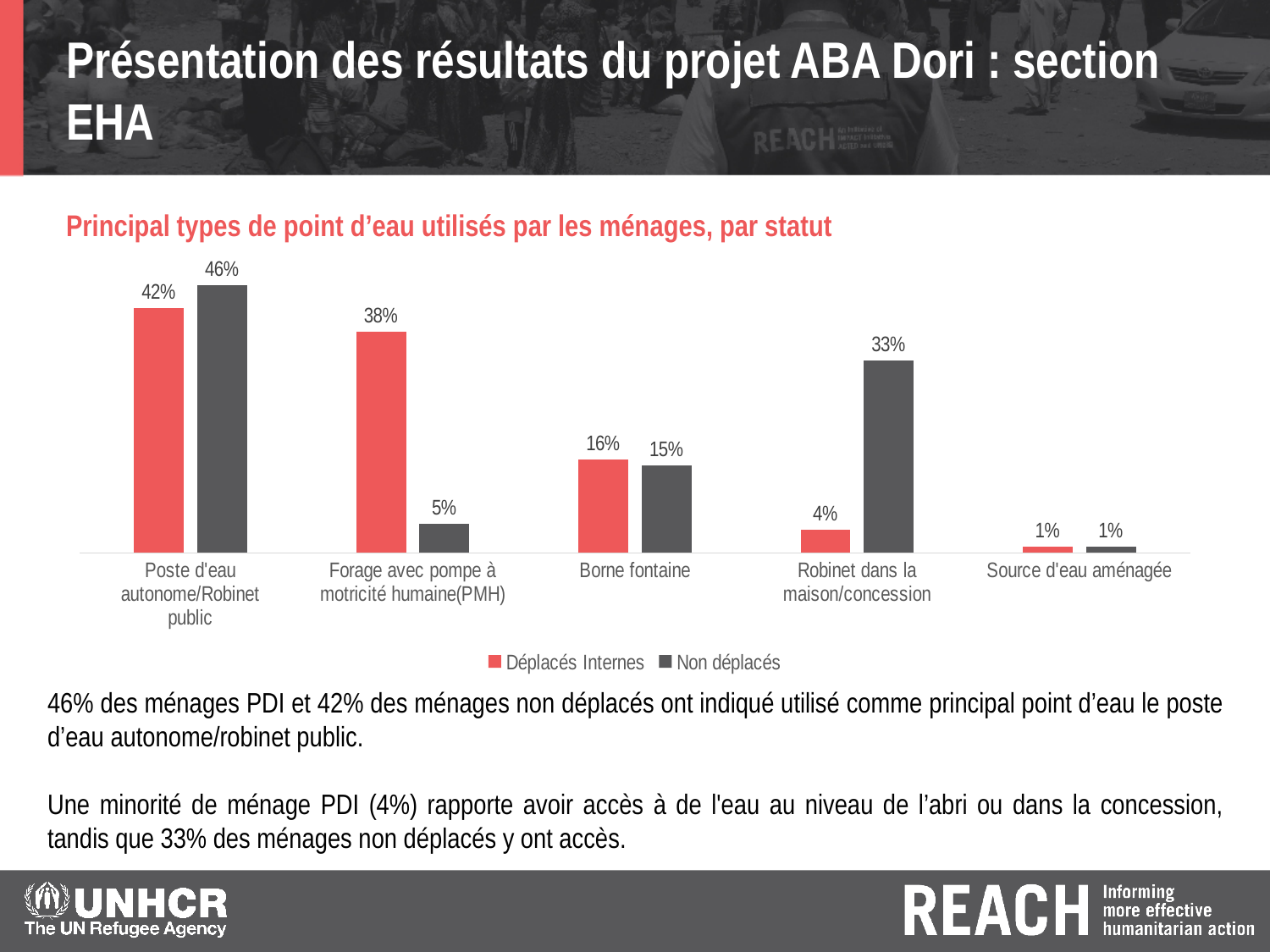
Which category has the highest value for Déplacés Internes? Poste d'eau autonome/Robinet public What is the difference between the Déplacés Internes and Non déplacés values for Forage avec pompe à motricité humaine(PMH)? 33% What is the value for Non déplacés for Poste d'eau autonome/Robinet public? 46% For Borne fontaine, which series has the larger value, Déplacés Internes or Non déplacés? Déplacés Internes What is the value for Non déplacés for Robinet dans la maison/concession? 33% Which category has the lowest value for Non déplacés? Source d'eau aménagée What is the difference between the Non déplacés and Déplacés Internes values for Robinet dans la maison/concession? 29% How many categories are shown on the x axis? 5 What kind of chart is shown on the slide? Bar chart What is the value for Déplacés Internes for Forage avec pompe à motricité humaine(PMH)? 38% Which series is shown in red in the legend? Déplacés Internes How many series does the legend list? 2